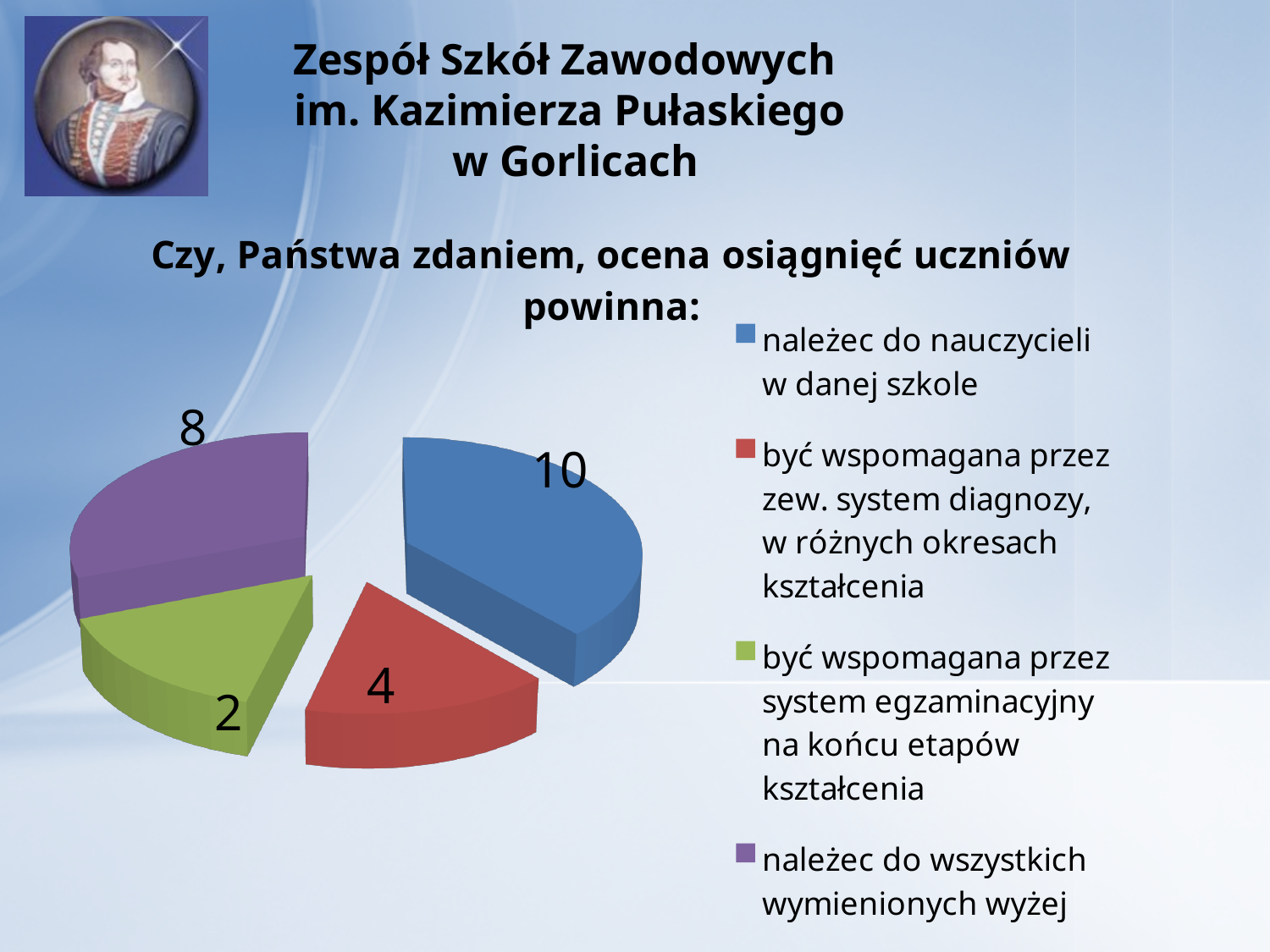
What colour is the slice for "należec do wszystkich wymienionych wyżej"? purple What kind of chart is shown on the slide? pie chart What is the difference between the value for "należec do nauczycieli w danej szkole" and the value for "należec do wszystkich wymienionych wyżej"? 2 What is the value for "być wspomagana przez zew. system diagnozy, w różnych okresach kształcenia"? 4 Which category has the largest slice of the pie? należec do nauczycieli w danej szkole What is the value for "być wspomagana przez system egzaminacyjny na końcu etapów kształcenia"? 2 What is the total of all the values shown in the pie chart? 24 What is the value for "należec do wszystkich wymienionych wyżej"? 8 What is the value for "należec do nauczycieli w danej szkole"? 10 Which is larger: the value for "być wspomagana przez zew. system diagnozy, w różnych okresach kształcenia" or the value for "być wspomagana przez system egzaminacyjny na końcu etapów kształcenia"? być wspomagana przez zew. system diagnozy, w różnych okresach kształcenia How many slices does the pie chart have? 4